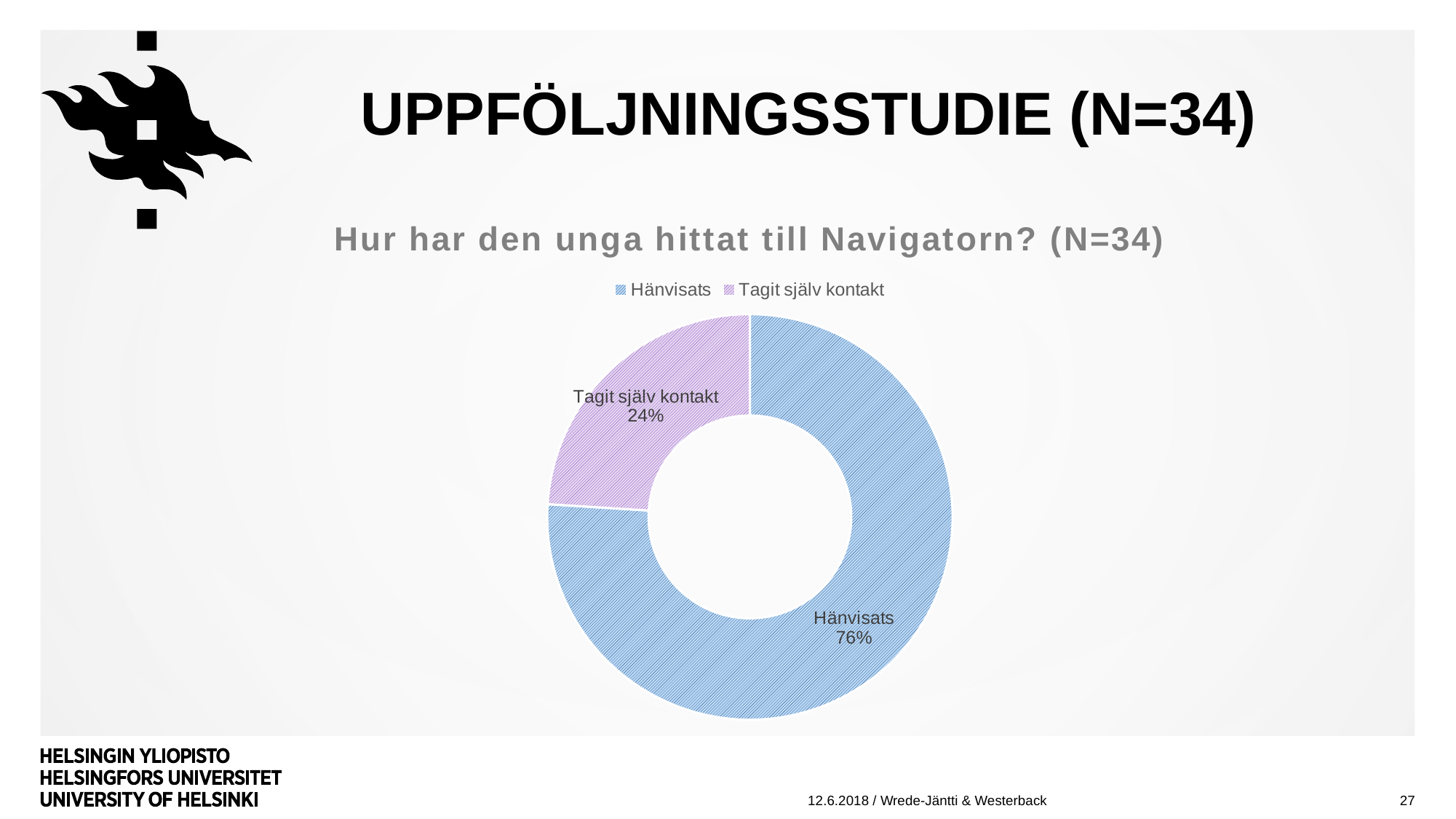
What is the title of the chart? Hur har den unga hittat till Navigatorn? (N=34) How many entries does the legend list? 2 What share of the pie does the Hänvisats slice take? 76% Which category has the smallest share of the chart? Tagit själv kontakt What percentage of the chart is labelled Tagit själv kontakt? 24% Which is larger, the share for Hänvisats or the share for Tagit själv kontakt? Hänvisats What kind of chart is shown on the slide? Pie chart (doughnut) Which category has the largest share of the chart? Hänvisats What percentage of the chart is labelled Hänvisats? 76% What colour is the Tagit själv kontakt slice? Purple What is the difference in percentage points between Hänvisats and Tagit själv kontakt? 52 How many categories does the chart show? 2